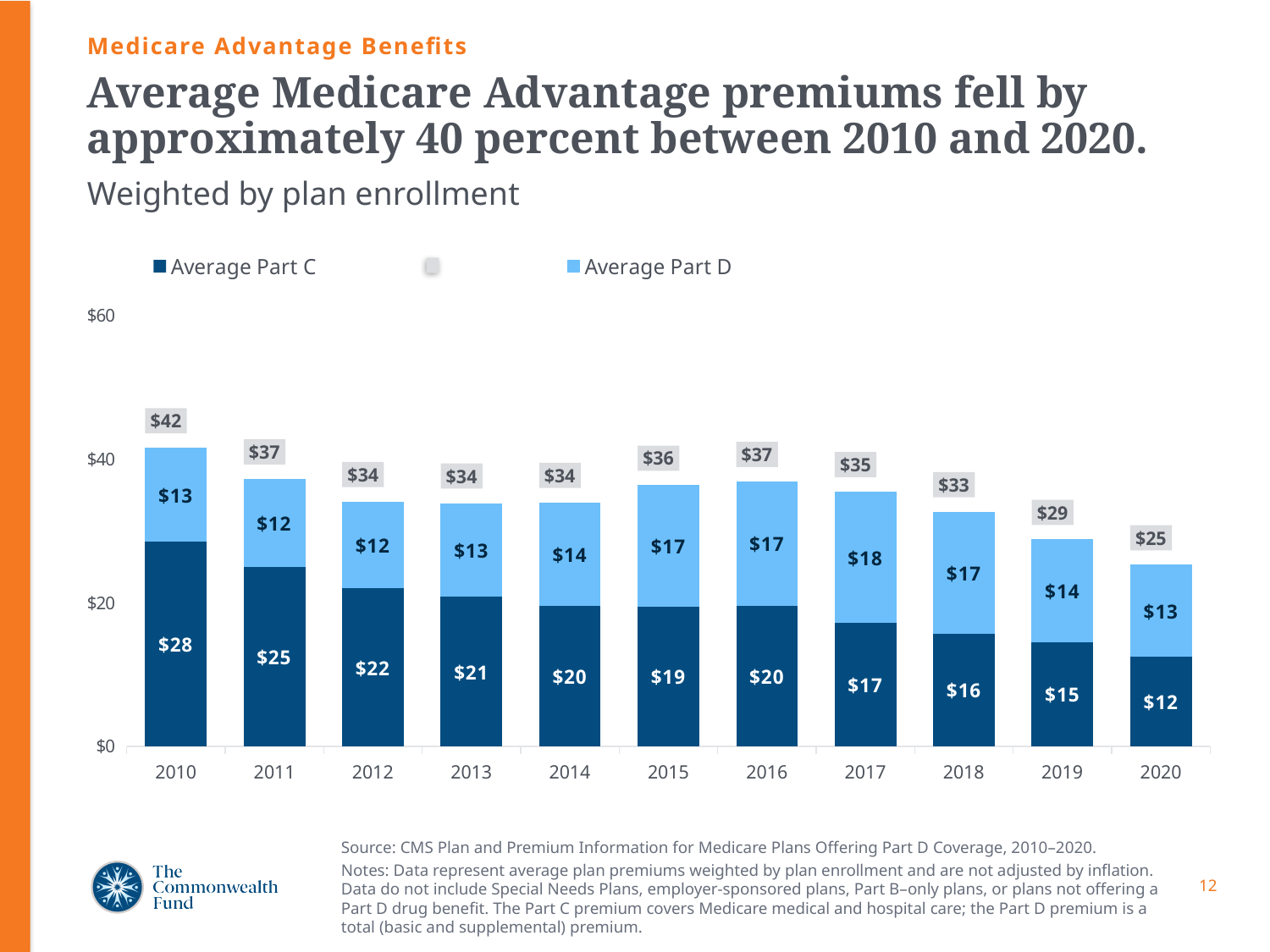
What kind of chart is shown on the slide? Stacked bar chart How many years are shown on the x axis? 11 Which year has the lowest Average Part C premium? 2020 Which is larger in 2017, the Average Part C premium or the Average Part D premium? Average Part D What is the total average premium shown for 2020? $25 What is the Average Part C premium for 2010? $28 Is the total average premium for 2019 greater or less than $40? less Does the Average Part C premium rise or fall from 2010 to 2020? Fall What is the Average Part D premium for 2017? $18 What is the difference between the Average Part C premium in 2010 and in 2020? $16 Which series is shown in the darker blue colour? Average Part C Which year has the highest total average premium? 2010